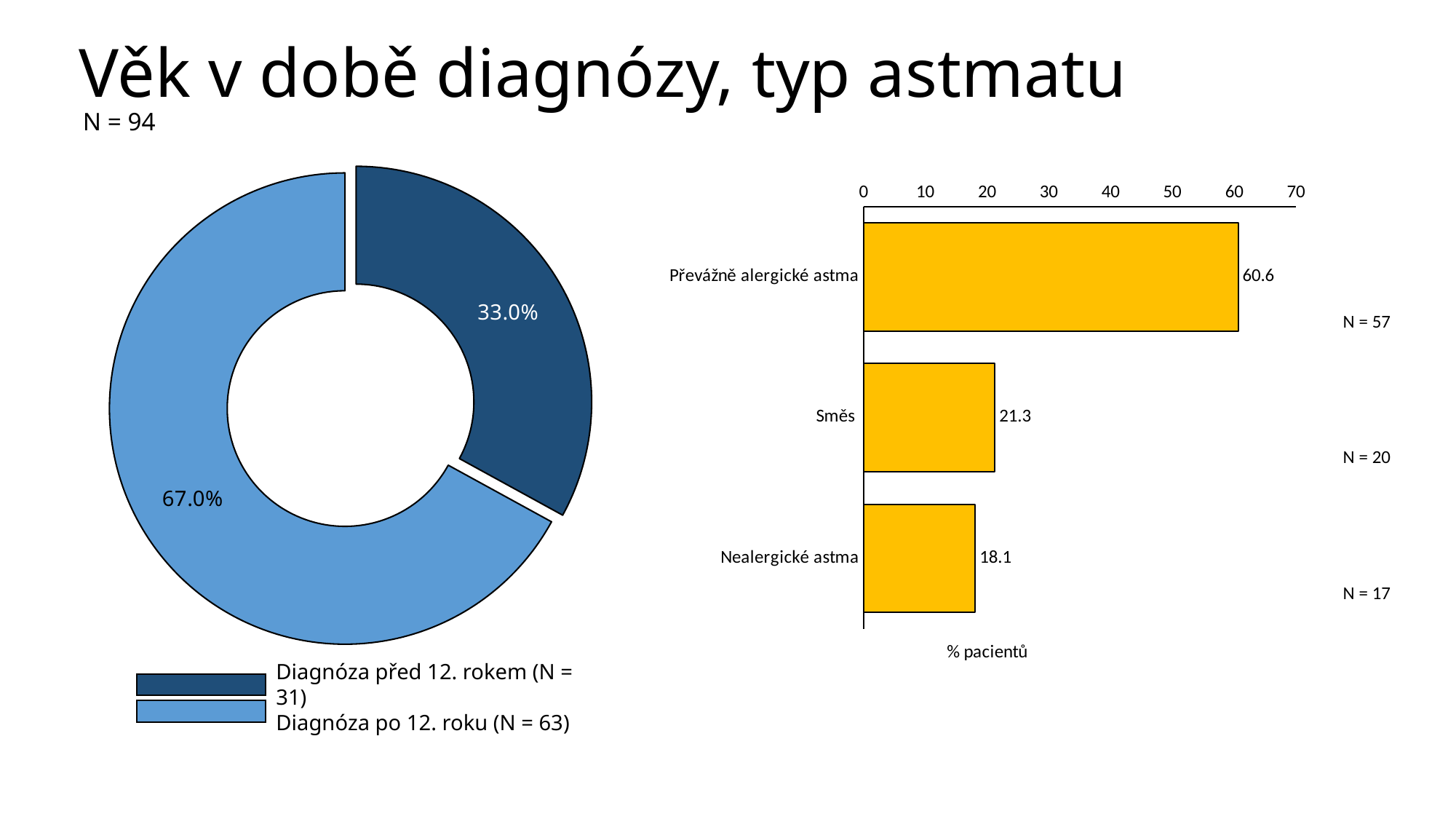
In the doughnut chart on the left, what share is labelled for 'Diagnóza po 12. roku (N = 63)'? 67.0% In the doughnut chart on the left, what share is labelled for 'Diagnóza před 12. rokem (N = 31)'? 33.0% In the doughnut chart on the left, which category has the larger share? Diagnóza po 12. roku (N = 63) In the bar chart on the right, which category has the lowest value? Nealergické astma In the bar chart on the right, what is the value for 'Převážně alergické astma'? 60.6 In the doughnut chart on the left, how many entries does the legend list? 2 In the bar chart on the right, what is the value for 'Nealergické astma'? 18.1 In the bar chart on the right, what is the value for 'Směs'? 21.3 In the bar chart on the right, how many categories are shown? 3 In the bar chart on the right, which category has the highest value? Převážně alergické astma In the bar chart on the right, what is the difference between the values for 'Převážně alergické astma' and 'Směs'? 39.3 What kind of chart is shown on the right side of the slide? Bar chart